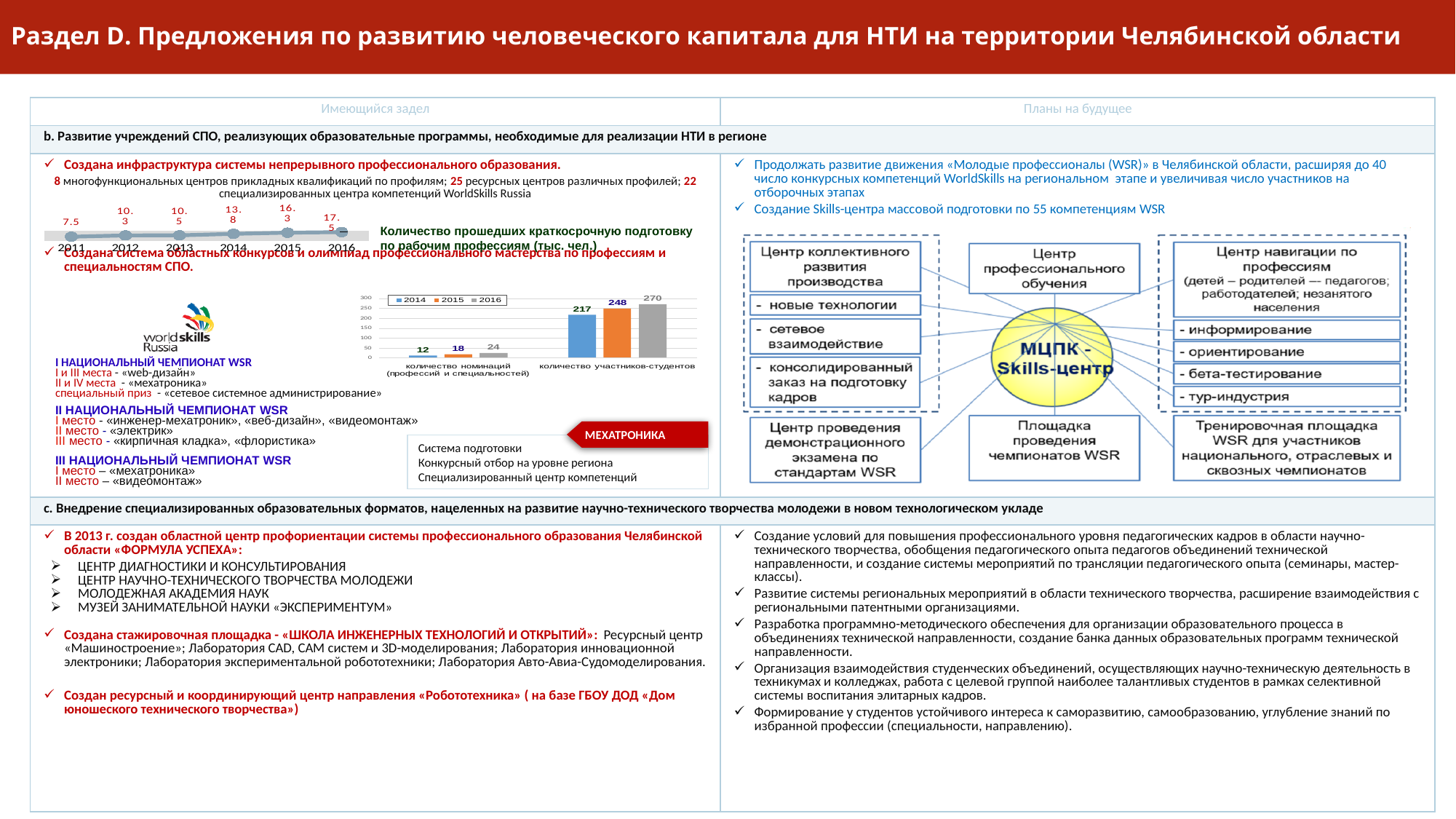
In the bar chart with the 2014/2015/2016 legend, what is the value for 2016 for количество участников-студентов? 270 In the bar chart with the 2014/2015/2016 legend, what is the difference between the 2016 and 2014 values for количество участников-студентов? 53 In the chart 'Количество прошедших краткосрочную подготовку по рабочим профессиям (тыс. чел.)', what is the value for 2011? 7.5 In the chart 'Количество прошедших краткосрочную подготовку по рабочим профессиям (тыс. чел.)', how many years are plotted? 6 In the bar chart with the 2014/2015/2016 legend, what is the value for 2015 for количество участников-студентов? 248 In the bar chart with the 2014/2015/2016 legend, how many series does the legend list? 3 What kind of chart is the chart titled 'Количество прошедших краткосрочную подготовку по рабочим профессиям (тыс. чел.)'? line chart In the bar chart with the 2014/2015/2016 legend, do the values for количество номинаций rise or fall from 2014 to 2016? rise In the bar chart with the 2014/2015/2016 legend, what is the difference between the 2016 and 2015 values for количество номинаций (профессий и специальностей)? 6 In the chart 'Количество прошедших краткосрочную подготовку по рабочим профессиям (тыс. чел.)', which year has the lowest value? 2011 In the bar chart with the 2014/2015/2016 legend, what is the value for 2014 for количество номинаций (профессий и специальностей)? 12 In the bar chart with the 2014/2015/2016 legend, which year has the highest value for количество участников-студентов? 2016